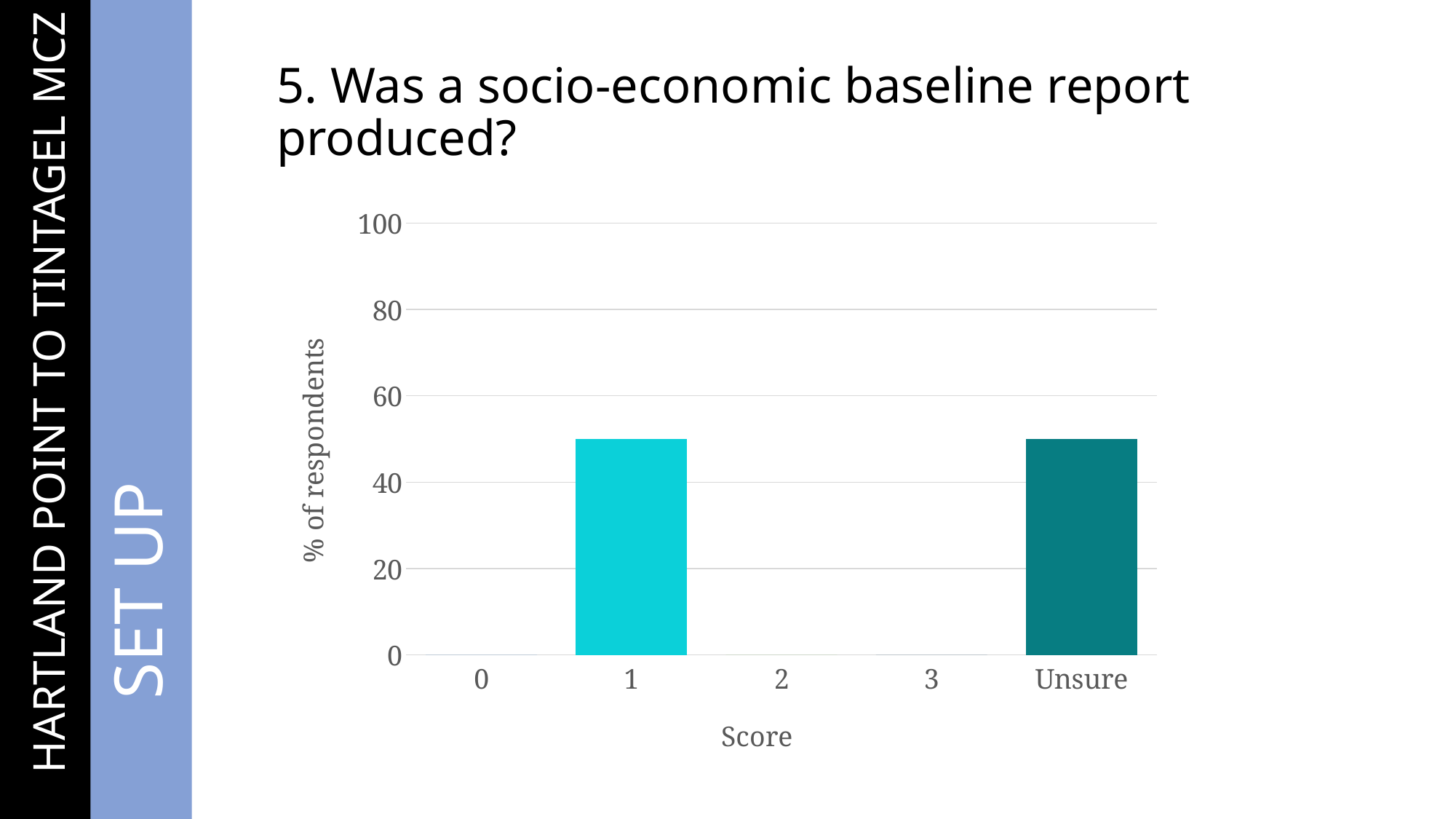
Is the value for score 1 greater or less than 60? less How many score categories are shown on the x axis? 5 Which score categories have no bar shown? 0, 2 and 3 Which is larger, the value for score 3 or the value for Unsure? Unsure What is the value for score 2? 0 Is the value for Unsure greater or less than 60? less What is the label of the x axis? Score What kind of chart is shown on the slide? bar chart What is the label of the y axis? % of respondents Is the value for Unsure greater or less than 40? greater Which is larger, the value for score 1 or the value for score 2? score 1